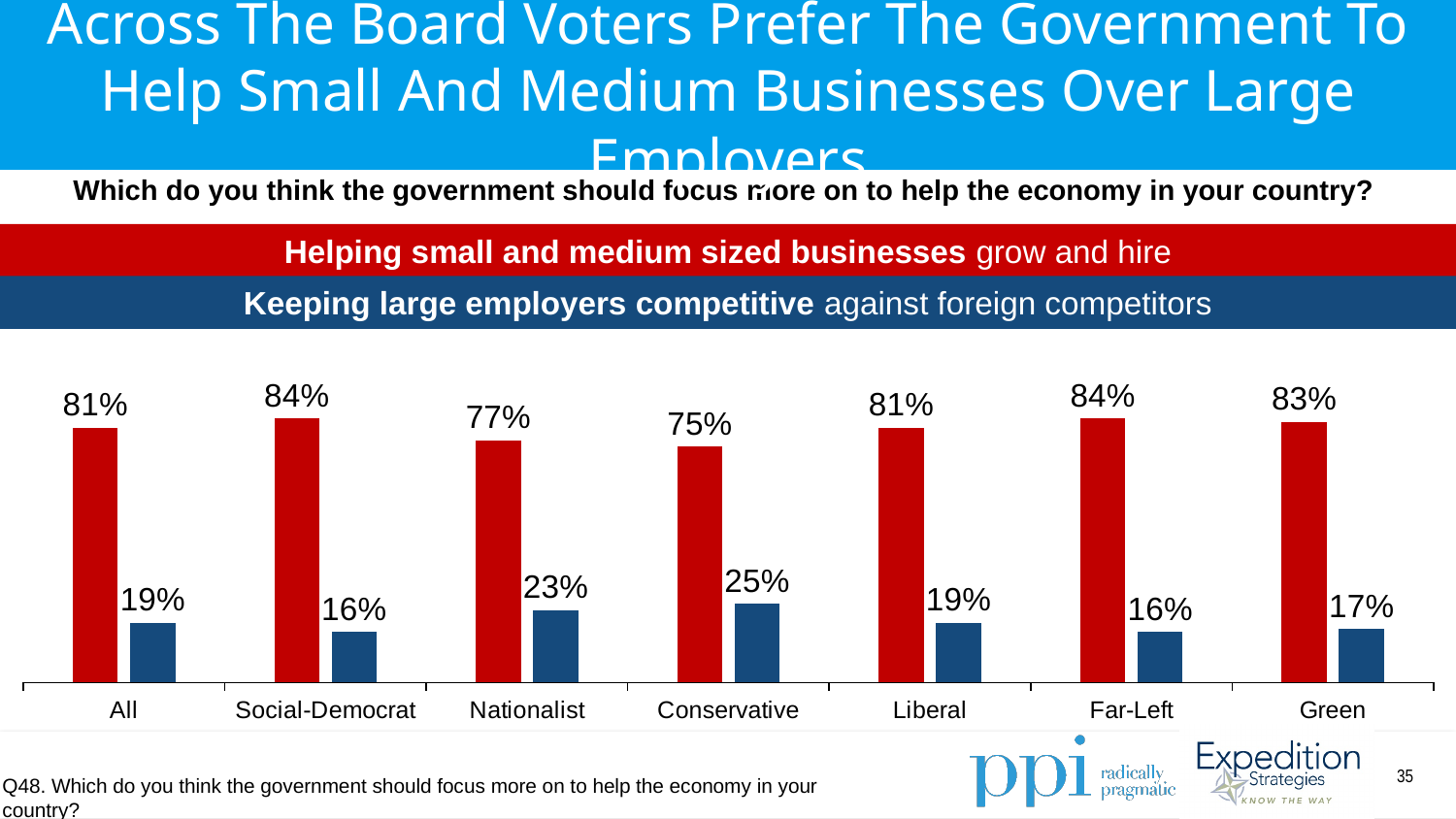
What is the difference between the share of Far-Left voters preferring small and medium sized businesses and the share preferring large employers? 68 percentage points Which is larger: the share of Liberal voters or the share of Green voters preferring to help small and medium sized businesses? Green What is the difference between the Social-Democrat and Nationalist shares preferring to keep large employers competitive? 7 percentage points How many response options (series) does the chart show? 2 What percentage of Nationalist voters prefer helping small and medium sized businesses? 77% How many voter groups are shown on the x axis of the chart? 7 What colour are the bars representing 'Keeping large employers competitive against foreign competitors'? Blue What percentage of Conservative voters prefer keeping large employers competitive against foreign competitors? 25% What type of chart is shown on the slide? Bar chart Which voter group has the lowest share preferring to help small and medium sized businesses? Conservative Which voter group has the highest share preferring to keep large employers competitive? Conservative What percentage of All voters prefer helping small and medium sized businesses grow and hire? 81%